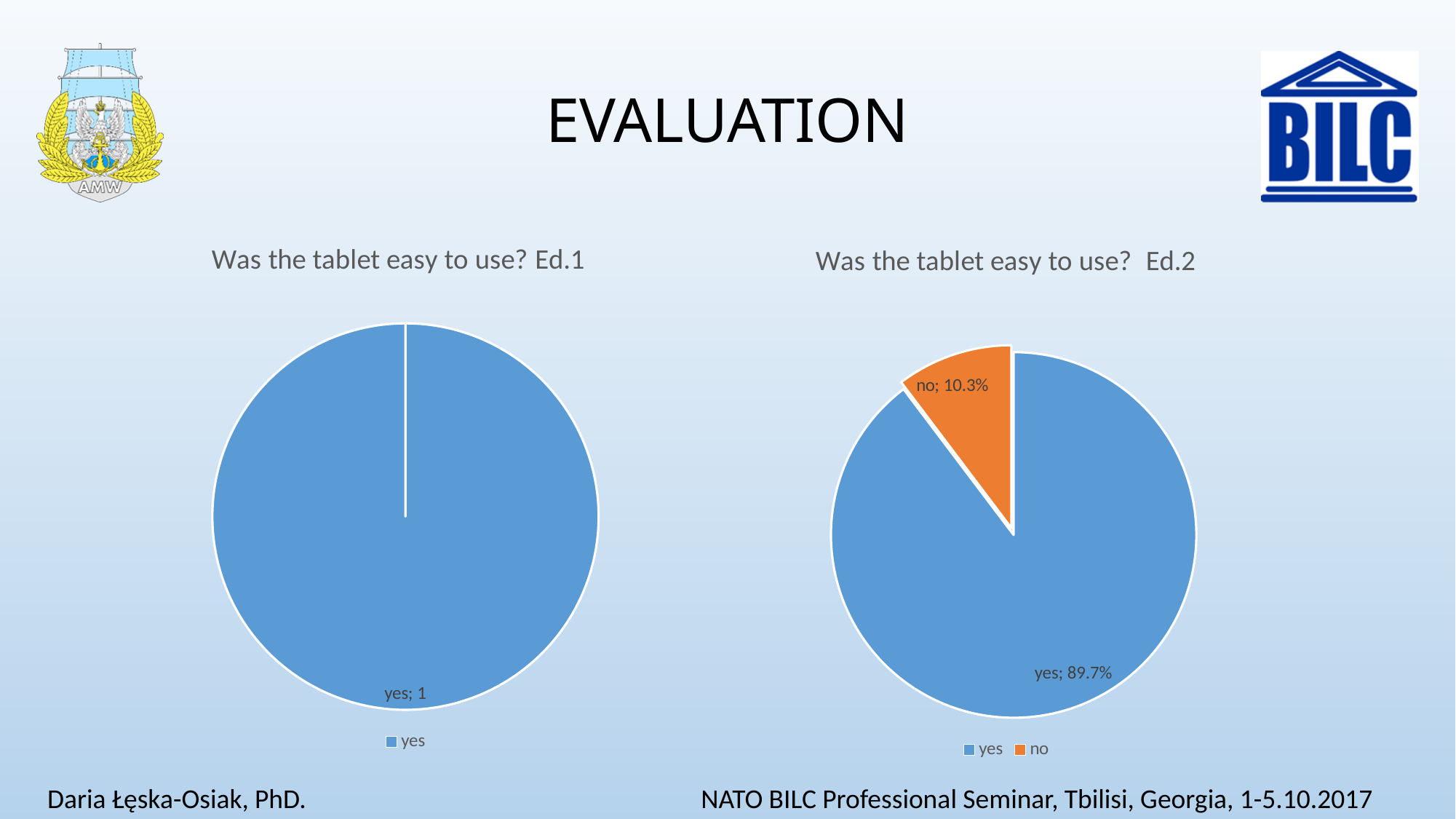
How many categories does the legend of the chart titled "Was the tablet easy to use? Ed.1" list? 1 In the chart titled "Was the tablet easy to use? Ed.2", what is the difference in percentage points between the "yes" and "no" shares? 79.4 In the chart titled "Was the tablet easy to use? Ed.2", what share of responses is "no"? 10.3% In the chart titled "Was the tablet easy to use? Ed.2", is the "yes" share larger or smaller than the "no" share? larger In the chart titled "Was the tablet easy to use? Ed.2", which category has the largest slice? yes In the chart titled "Was the tablet easy to use? Ed.2", what share of responses is "yes"? 89.7% In the chart titled "Was the tablet easy to use? Ed.2", which category has the smallest slice? no What is the title of the chart on the right of the slide? Was the tablet easy to use? Ed.2 What kind of chart is the chart on the left of the slide? pie chart In the chart titled "Was the tablet easy to use? Ed.2", what colour is the "no" slice? orange In the chart titled "Was the tablet easy to use? Ed.1", what value is labelled on the "yes" slice? 1 How many categories does the legend of the chart titled "Was the tablet easy to use? Ed.2" list? 2